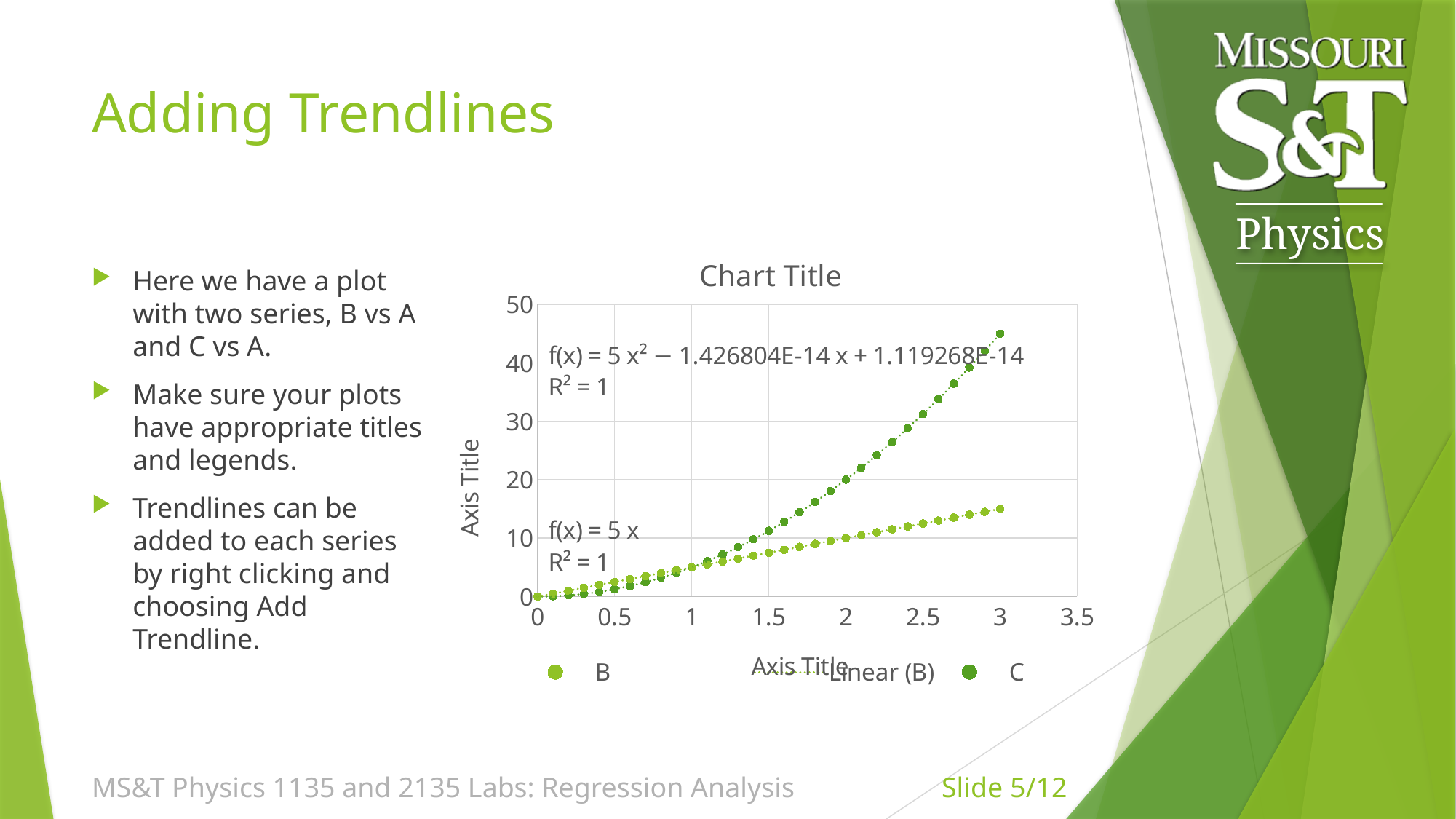
What equation is shown for the linear trendline on the chart? f(x) = 5 x At x = 3, which series has the higher value, B or C? C How many entries does the chart's legend list? 3 What are the legend entries of the chart? B, Linear (B), C What is the R² value shown for the linear trendline f(x) = 5 x? 1 Is the value of series B at x = 3 greater or less than 20? less Is the value of series C at x = 2.5 greater or less than 30? greater What is the title of the chart? Chart Title What is the R² value shown for the quadratic trendline on the chart? 1 What kind of chart is shown on the slide? scatter chart Is the value of series C at x = 3 greater or less than 40? greater Do the values of series B rise or fall as x increases? rise